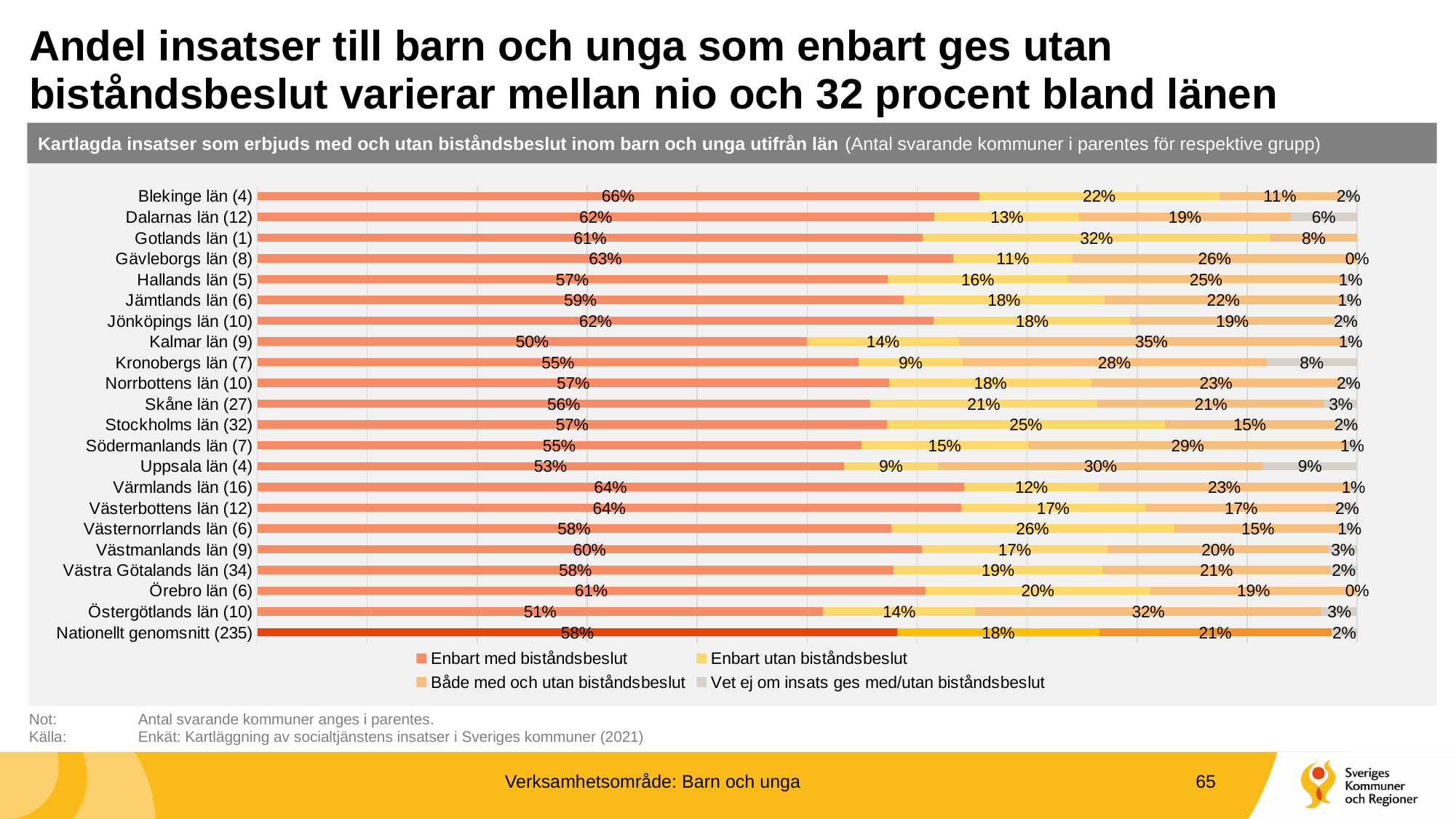
What is the value for 'Enbart utan biståndsbeslut' for Nationellt genomsnitt (235)? 18% Which category has the lowest value for 'Enbart med biståndsbeslut'? Kalmar län (9) What is the value for 'Enbart med biståndsbeslut' for Blekinge län (4)? 66% What is the value for 'Vet ej om insats ges med/utan biståndsbeslut' for Uppsala län (4)? 9% Which category has the highest value for 'Både med och utan biståndsbeslut'? Kalmar län (9) What is the value for 'Enbart utan biståndsbeslut' for Gotlands län (1)? 32% How many series does the legend list? 4 Which category has the highest value for 'Enbart med biståndsbeslut'? Blekinge län (4) What kind of chart is shown on the slide? Stacked bar chart How many categories (bars) are shown in the chart? 22 Which has the larger 'Enbart utan biståndsbeslut' value, Stockholms län (32) or Uppsala län (4)? Stockholms län (32) What is the difference in percentage points between the 'Både med och utan biståndsbeslut' values for Kalmar län (9) and Blekinge län (4)? 24